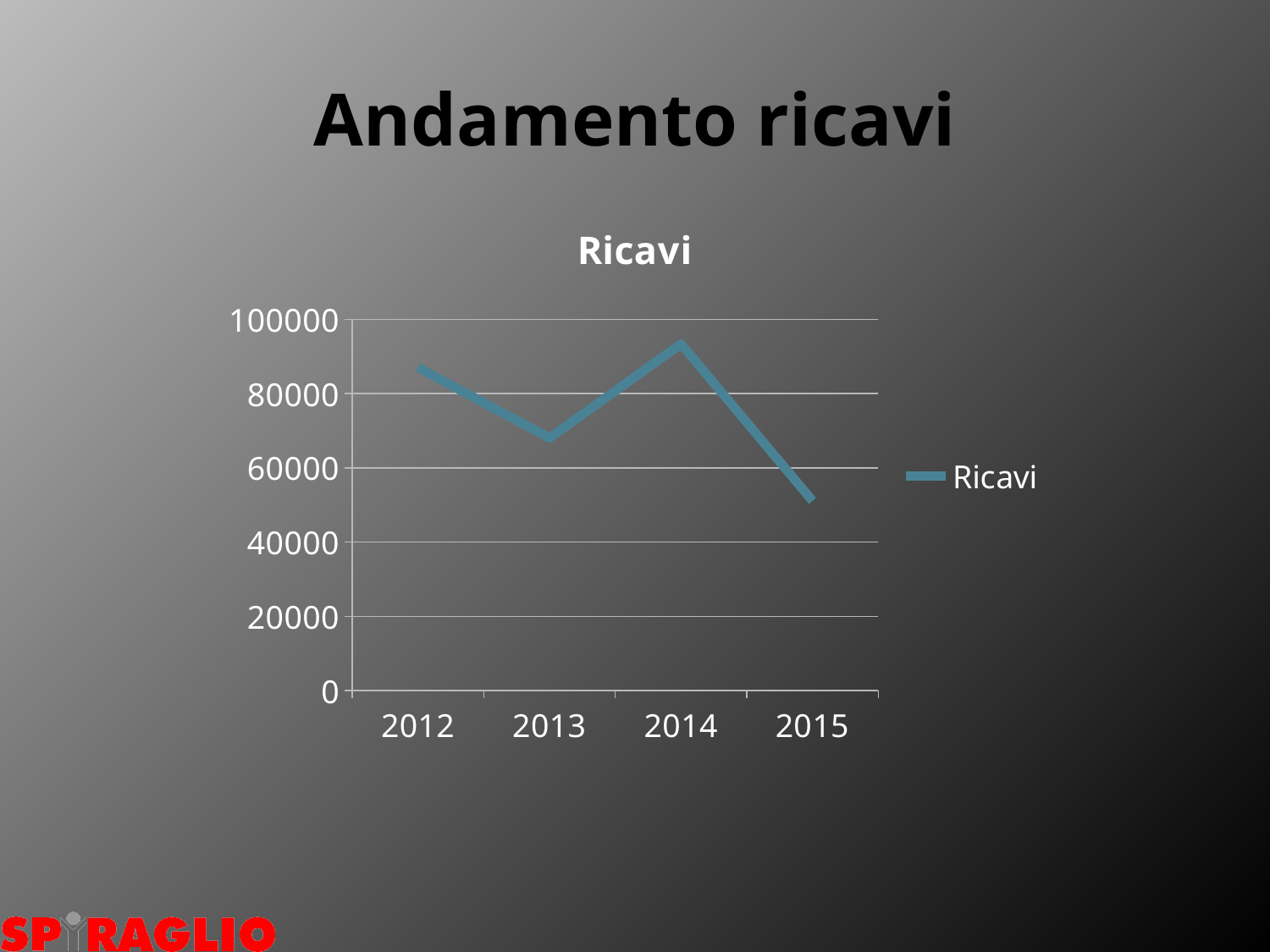
Is the value for 2015 greater or less than 60000? less Which year has the larger value, 2013 or 2014? 2014 Is the value for 2012 greater or less than 80000? greater Which year has the lowest value for Ricavi? 2015 Is the value for 2013 greater or less than 80000? less What type of chart is shown on the slide? line chart How many series does the legend list? 1 Which year has the highest value for Ricavi? 2014 How many years are plotted on the x axis? 4 What is the title of the chart? Ricavi Does the value for Ricavi rise or fall from 2014 to 2015? fall